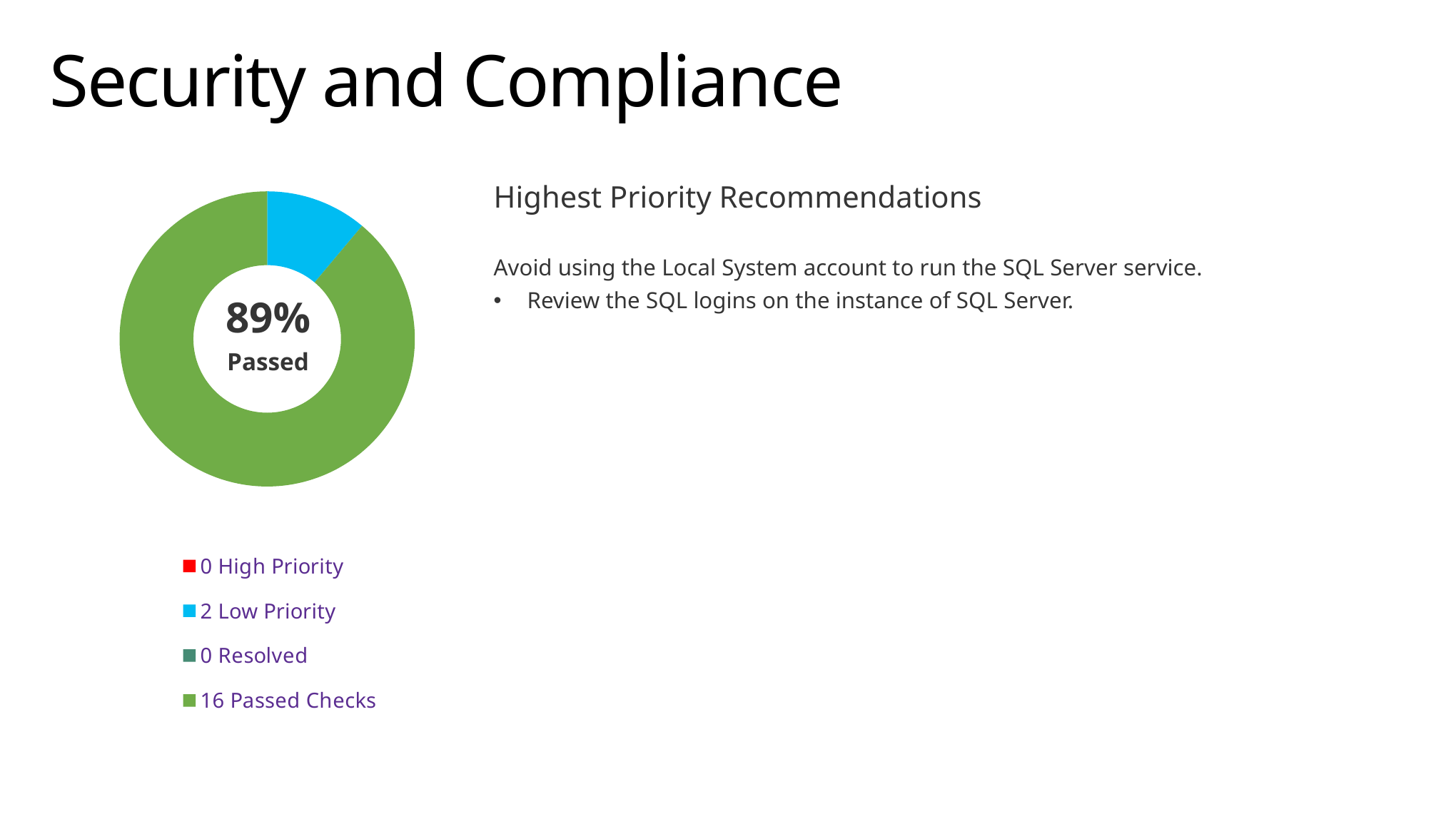
How many Low Priority items does the legend show? 2 How many Resolved items does the legend show? 0 Which category has the highest count in the chart? Passed Checks How many High Priority items does the legend show? 0 What percentage is shown in the centre of the doughnut chart? 89% What is the total of all the counts listed in the legend? 18 What is the difference between the number of Passed Checks and the number of Low Priority items? 14 Which is larger, the number of Low Priority items or the number of High Priority items? Low Priority What kind of chart is shown on the slide? Doughnut chart How many entries does the chart legend list? 4 What colour represents Passed Checks in the chart? Green How many Passed Checks does the legend show? 16